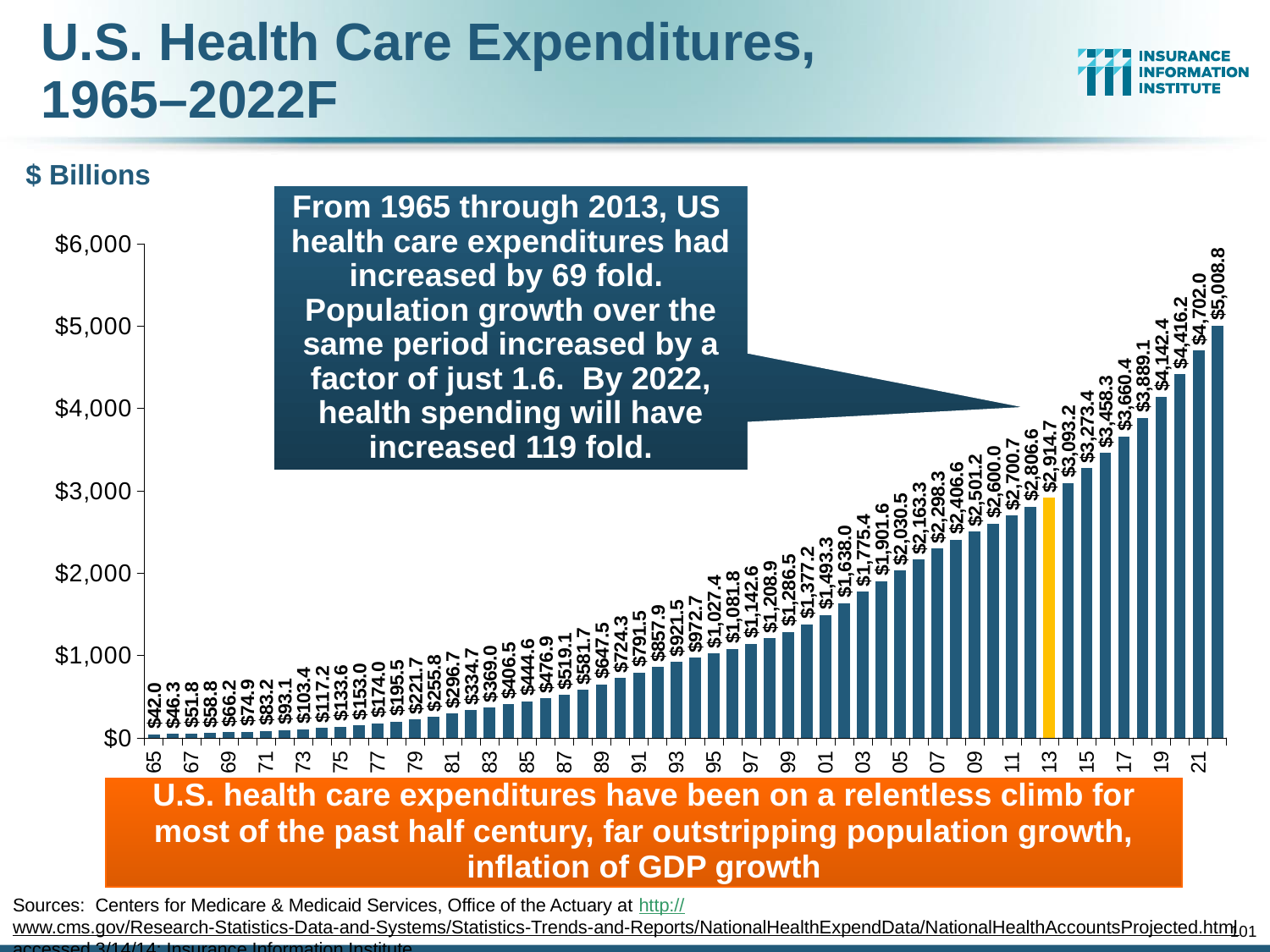
What is the value of U.S. health care expenditures for 2013 (the highlighted bar)? $2,914.7 Which year has the lowest value on the chart? 1965 What is the difference between the 2022 value and the 2013 value? $2,094.1 What is the value of U.S. health care expenditures for 2000? $1,377.2 What is the value of U.S. health care expenditures for 1965? $42.0 What type of chart is shown on the slide? Bar chart Which year's bar is highlighted in a different colour from the rest? 2013 Do the values generally rise or fall from 1965 to 2022? Rise Is the value for 2013 greater or less than $2,000? greater What is the forecast value of U.S. health care expenditures for 2022? $5,008.8 Which year has the highest value on the chart? 2022 Which is larger, the value for 2005 or the value for 2010? 2010